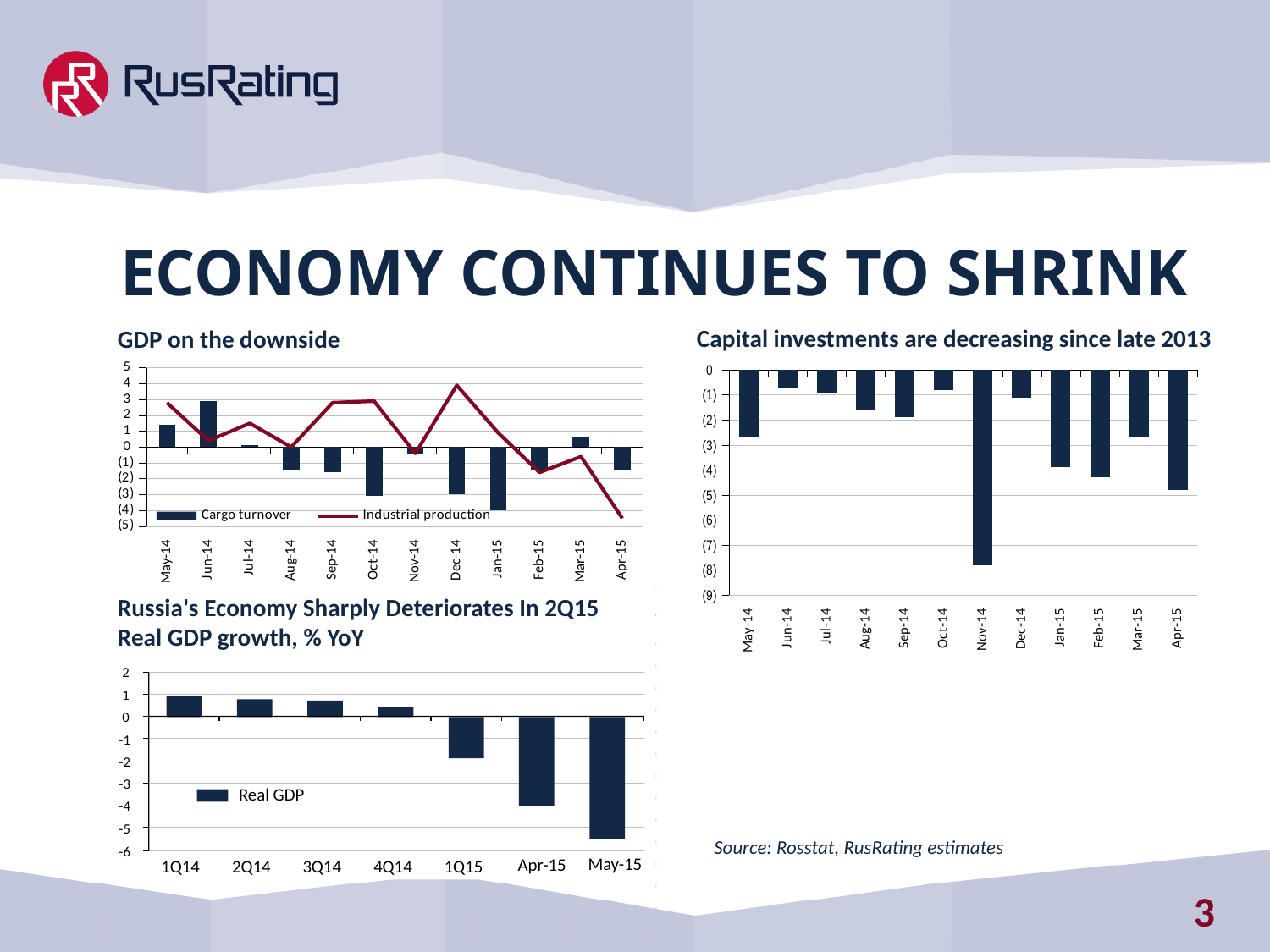
In the 'GDP on the downside' chart, in which month is Cargo turnover lowest? Jan-15 In the 'Real GDP growth, % YoY' chart, which period has the lowest Real GDP value? May-15 In the 'Real GDP growth, % YoY' chart, how many periods are shown on the x axis? 7 In the 'GDP on the downside' chart, how many series does the legend list? 2 In the 'GDP on the downside' chart, in which month is Cargo turnover highest? Jun-14 In the 'GDP on the downside' chart, is the Industrial production value for Apr-15 greater or less than (4)? less In the 'GDP on the downside' chart, in which month does Industrial production reach its highest value? Dec-14 In the 'Capital investments are decreasing since late 2013' chart, is the value for Nov-14 greater or less than (7)? less In the 'Real GDP growth, % YoY' chart, do the values generally rise or fall from 1Q14 to May-15? fall In the 'Capital investments are decreasing since late 2013' chart, which month has the lowest value? Nov-14 What kind of chart is 'Capital investments are decreasing since late 2013'? bar chart In the 'Real GDP growth, % YoY' chart, is the value for 1Q15 greater or less than -1? less